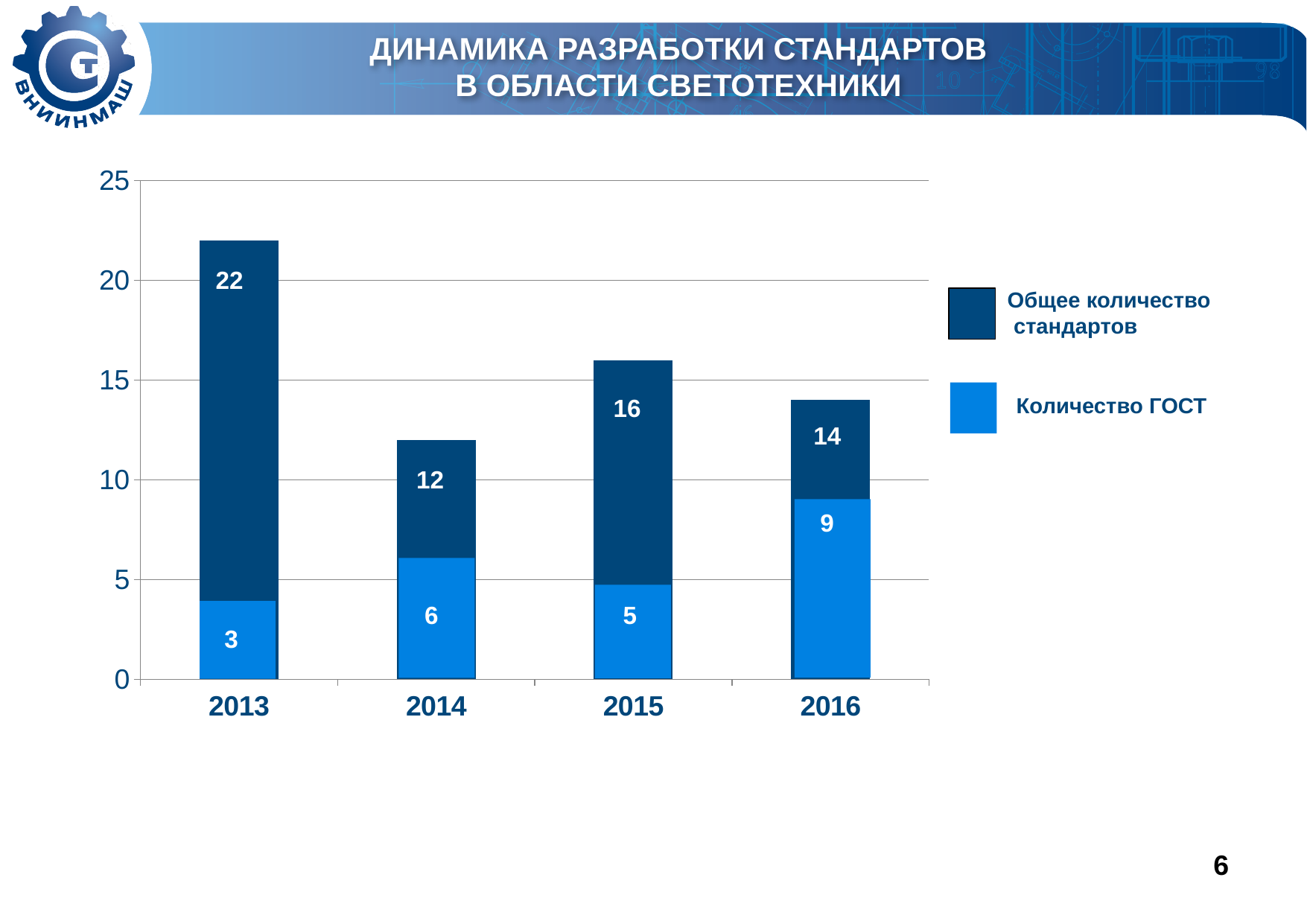
Which year has the lowest value for Количество ГОСТ? 2013 What is the value of Количество ГОСТ for 2016? 9 Which year has the highest value for Общее количество стандартов? 2013 What is the value of Общее количество стандартов for 2013? 22 How many series does the legend list? 2 What is the title of the slide? ДИНАМИКА РАЗРАБОТКИ СТАНДАРТОВ В ОБЛАСТИ СВЕТОТЕХНИКИ What is the value of Общее количество стандартов for 2015? 16 Which is larger: Количество ГОСТ in 2015 or in 2016? 2016 What kind of chart is shown on the slide? Bar chart How many years are shown on the x axis? 4 What is the difference between Общее количество стандартов and Количество ГОСТ in 2013? 19 What is the value of Количество ГОСТ for 2014? 6